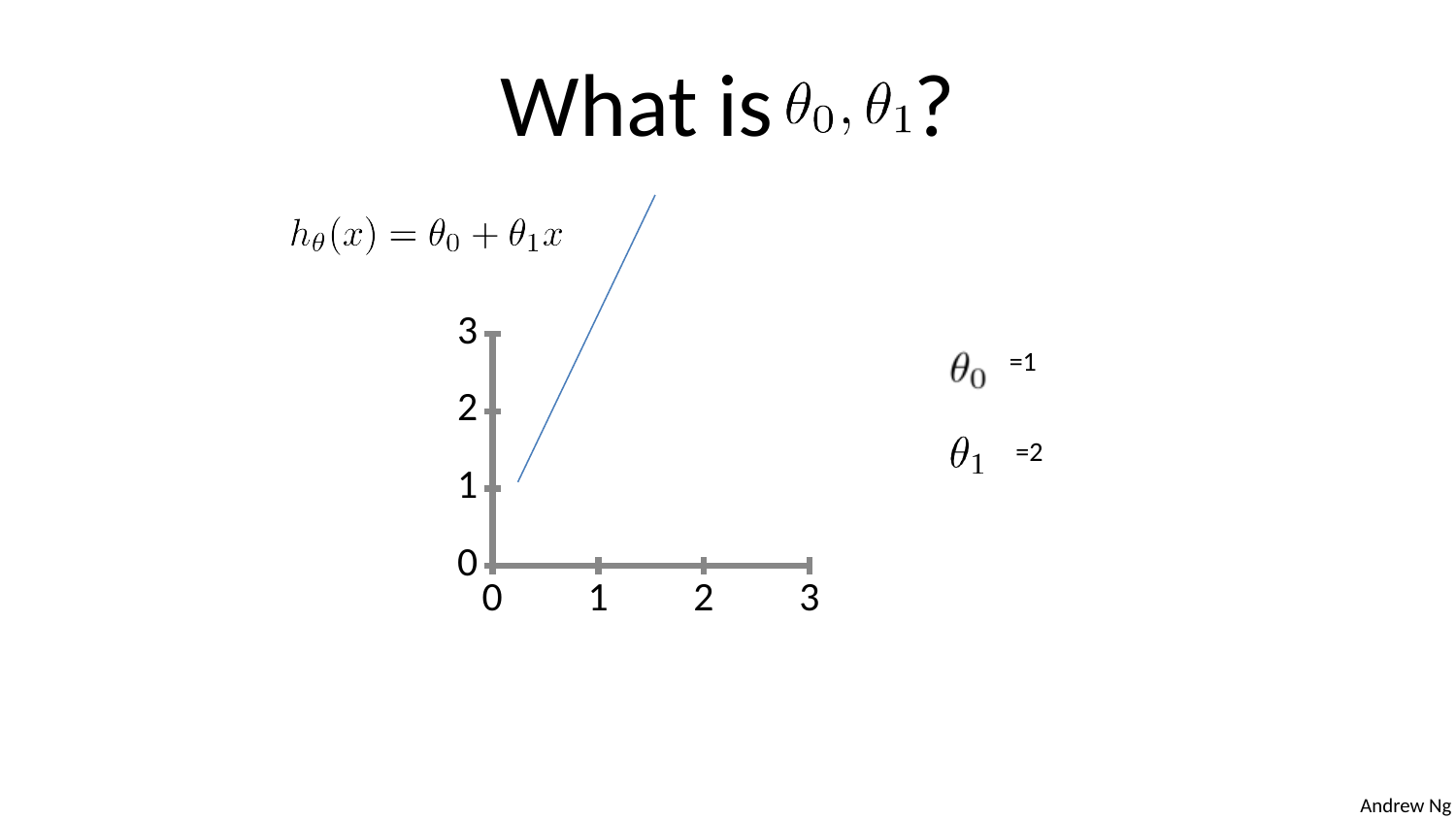
According to the slide, what is the value of θ0? 1 How many tick labels are shown on the x axis? 4 What kind of chart is shown on the slide? line chart Is the value of the plotted line at x = 1 greater or less than 2? greater Is the value of the plotted line at x = 0 greater or less than 2? less Does the plotted line rise or fall as x increases? rises What is the highest value labelled on the y axis? 3